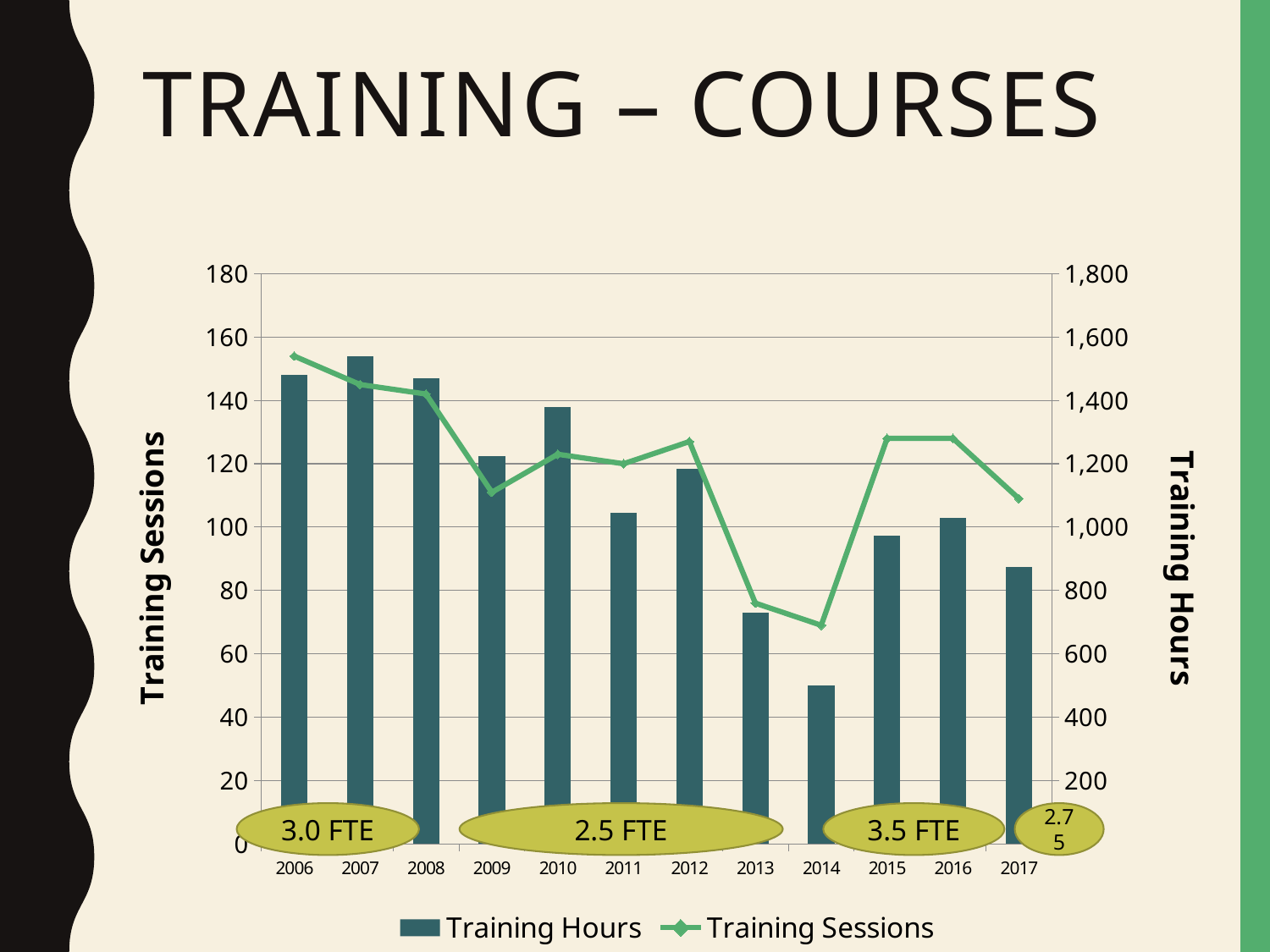
Which year has the highest Training Hours? 2007 What type of chart is shown on the slide? A combination bar and line chart Is the value for Training Hours in 2014 greater or less than 600? less What is the title of the right-hand vertical axis? Training Hours How many series does the legend list? 2 Which year has the lowest Training Hours? 2014 Which year has the highest number of Training Sessions? 2006 Which year has the lowest number of Training Sessions? 2014 Which year has more Training Hours, 2010 or 2011? 2010 Do Training Hours generally rise or fall from 2006 to 2014? fall Is the value for Training Sessions in 2013 greater or less than 80? less How many years are shown on the x axis? 12